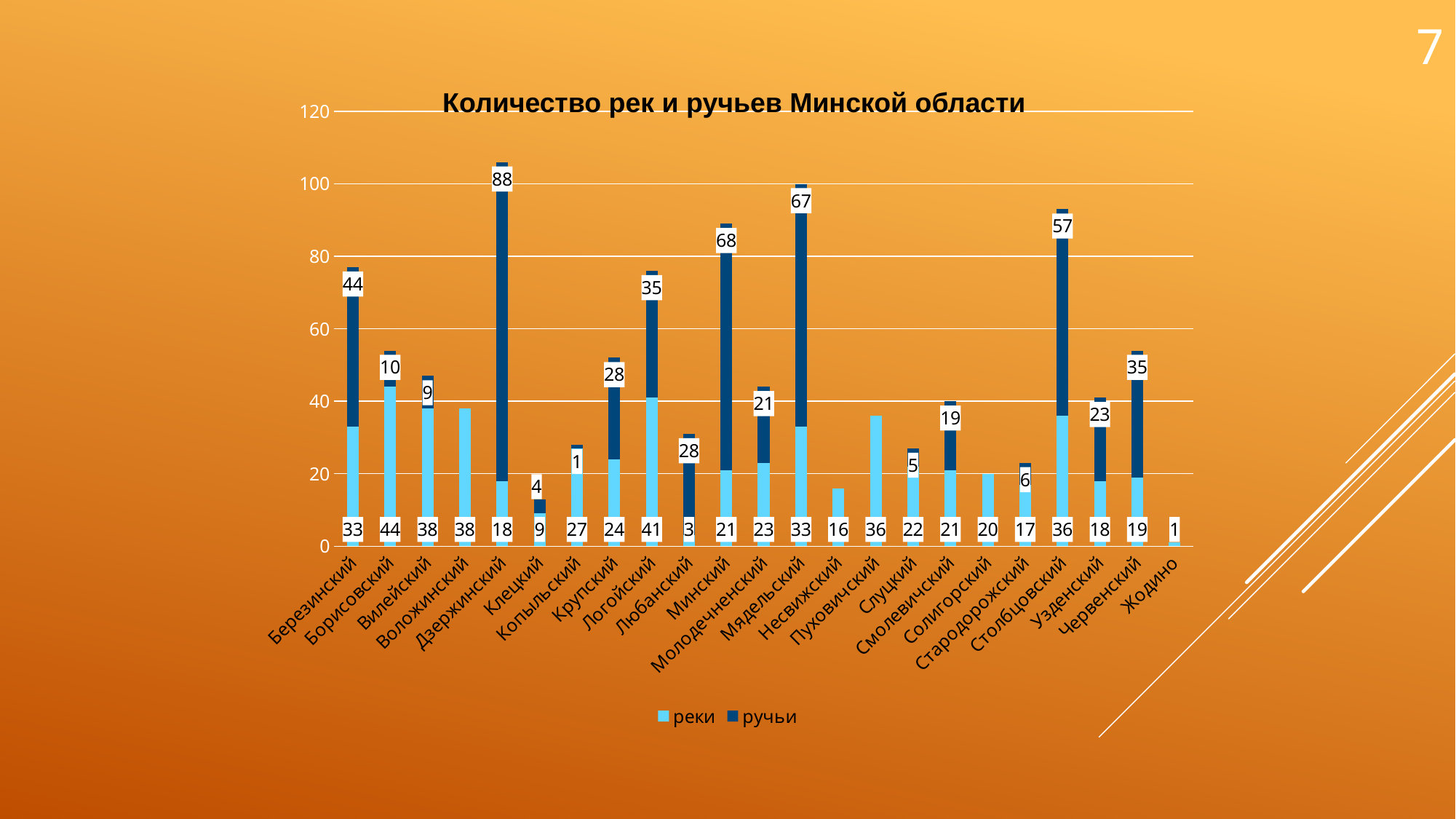
How many districts (categories) are shown on the x axis? 23 For Минский, how much larger is the ручьи value than the реки value? 47 Which category has the lowest value for реки? Жодино What is the total of реки and ручьи for Столбцовский? 93 Which has more реки: Борисовский or Логойский? Борисовский How many series does the legend list? 2 What is the value of ручьи for Дзержинский? 88 How many rivers (реки) are shown for Логойский? 41 What is the value of ручьи for Червенский? 35 What type of chart is shown on the slide? Stacked bar chart What is the total height of the stacked bar for Березинский (реки plus ручьи)? 77 Which district has the highest number of ручьи? Дзержинский